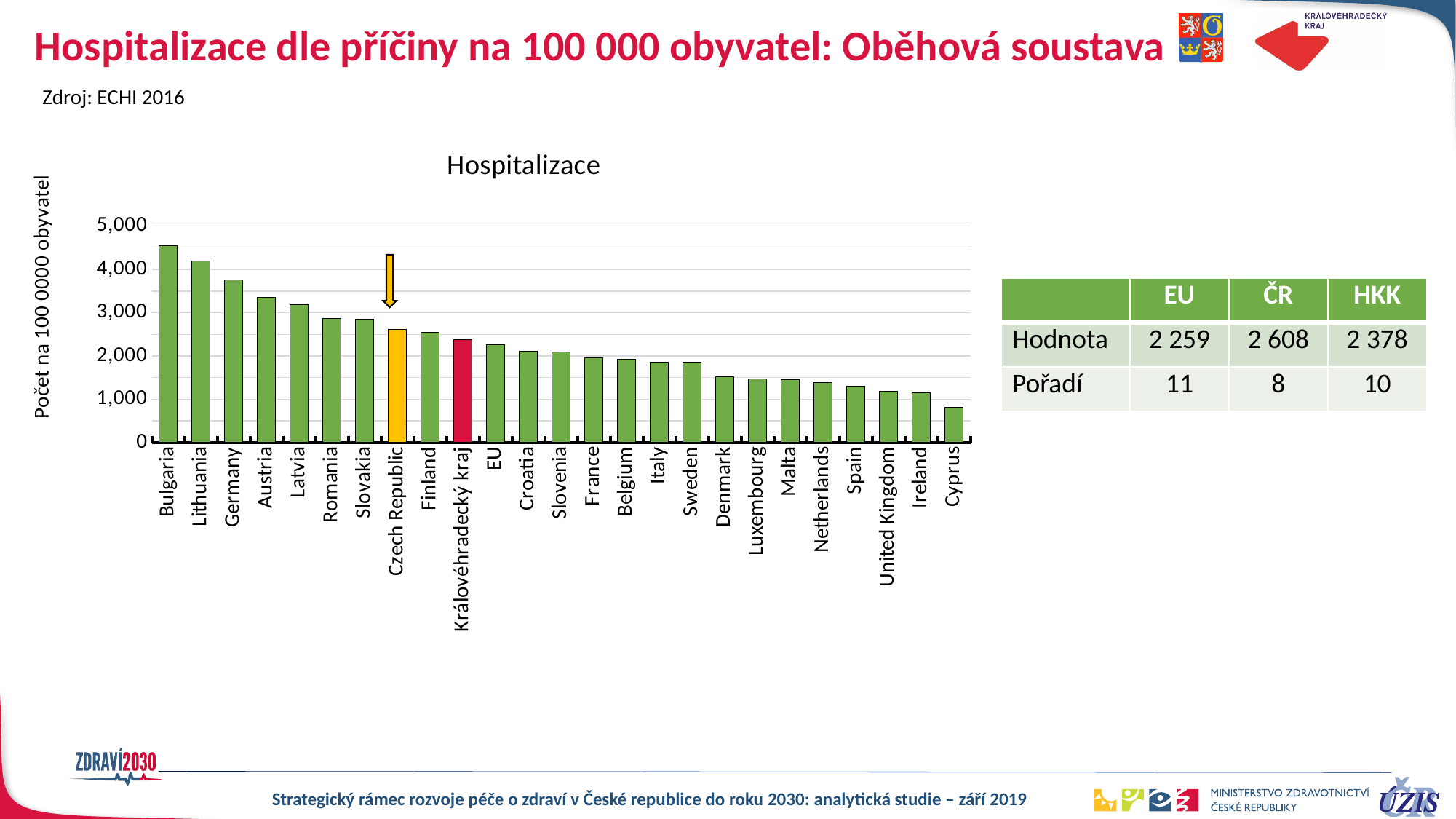
Is the value for Germany greater or less than 3,000? greater Is the value for Cyprus greater or less than 1,000? less What kind of chart is shown on the slide? bar chart Do the values rise or fall moving from left to right along the x axis? fall According to the table on the slide, what is the difference between the value for ČR and the value for EU? 349 How many bars (categories) are plotted in the chart? 25 Which country has the highest hospitalization rate in the chart? Bulgaria Which country has the lowest hospitalization rate in the chart? Cyprus According to the table on the slide, what is the value (Hodnota) for ČR? 2 608 What is the title of the chart? Hospitalizace Is the value for Bulgaria greater or less than 4,000? greater Which is larger, the value for Lithuania or the value for Germany? Lithuania